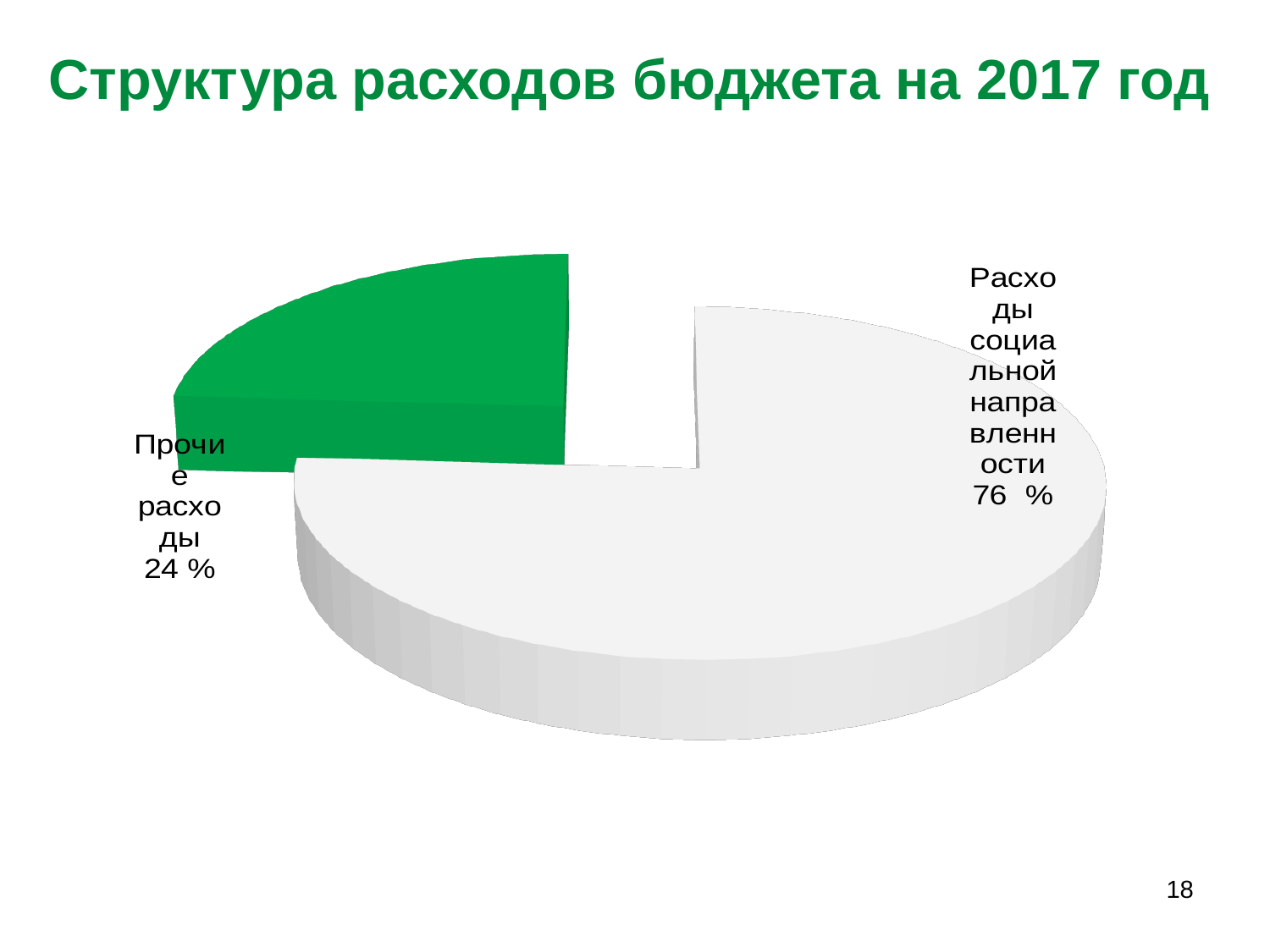
How many slices does the pie chart have? 2 What share of the pie is labelled "Расходы социальной направленности"? 76 % Which is larger: "Прочие расходы" or "Расходы социальной направленности"? Расходы социальной направленности What kind of chart is shown on the slide? pie chart Which slice of the pie is the largest? Расходы социальной направленности What colour is the slice for "Прочие расходы"? green What is the title of the chart slide? Структура расходов бюджета на 2017 год Which slice of the pie is the smallest? Прочие расходы What is the difference in percentage points between "Расходы социальной направленности" and "Прочие расходы"? 52 What share of the pie is labelled "Прочие расходы"? 24 %